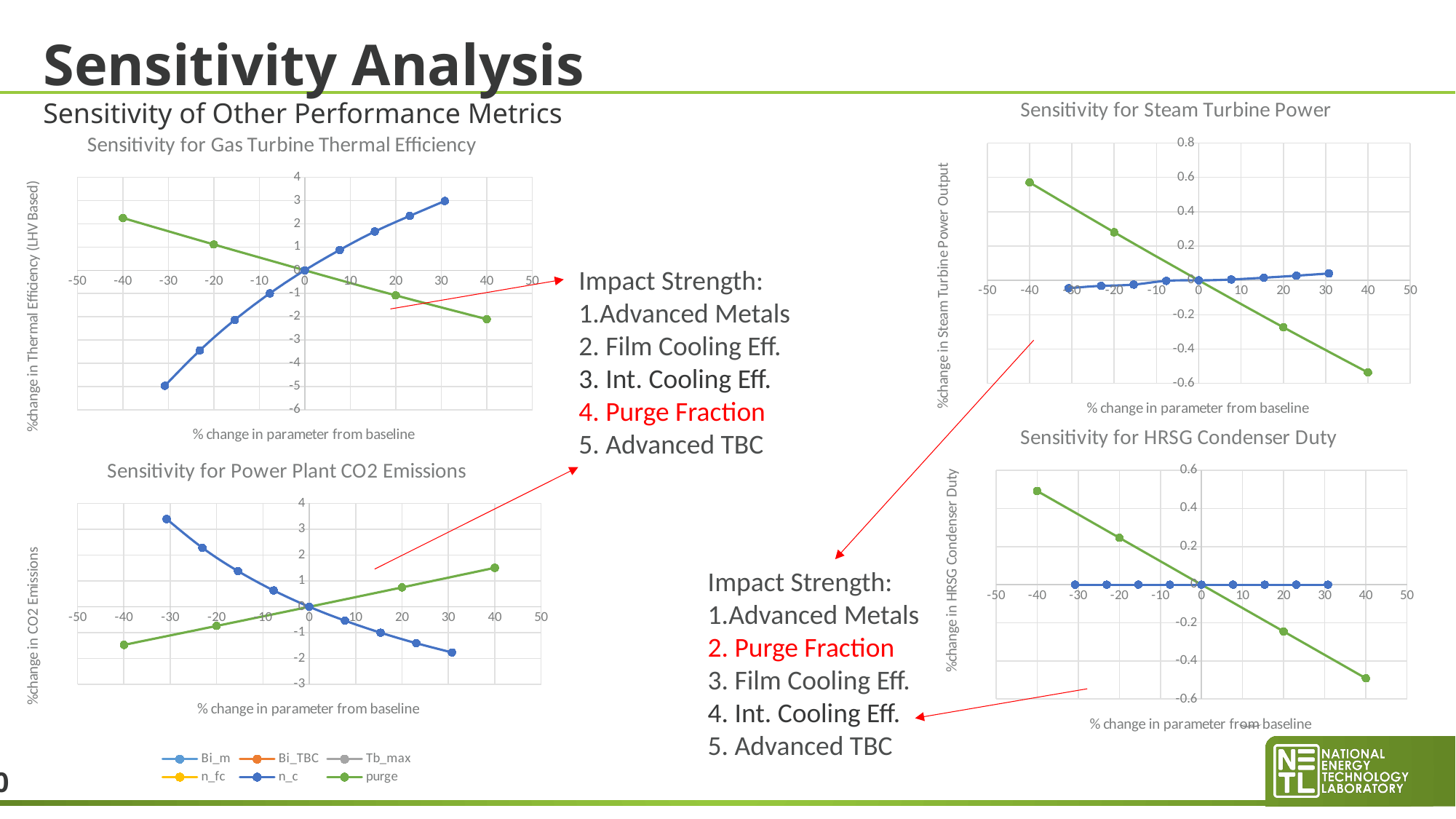
In the "Sensitivity for Gas Turbine Thermal Efficiency" chart, is the purge value at -40% change greater or less than 2? greater How many series does the legend at the bottom of the slide list? 6 In the "Sensitivity for Steam Turbine Power" chart, which series is larger at -40% change, purge or n_c? purge In the "Sensitivity for Gas Turbine Thermal Efficiency" chart, does the green purge line rise or fall as the % change in parameter increases? fall In the "Sensitivity for Power Plant CO2 Emissions" chart, is the n_c value at -30% change greater or less than 3? greater What is the x-axis title of the "Sensitivity for HRSG Condenser Duty" chart? % change in parameter from baseline In the "Sensitivity for HRSG Condenser Duty" chart, is the purge value at 40% change greater or less than -0.4? less In the "Sensitivity for Gas Turbine Thermal Efficiency" chart, does the blue n_c line rise or fall as the % change in parameter increases? rise What kind of chart is "Sensitivity for Gas Turbine Thermal Efficiency"? line chart In the "Sensitivity for Power Plant CO2 Emissions" chart, does the blue n_c line rise or fall as the % change in parameter increases? fall